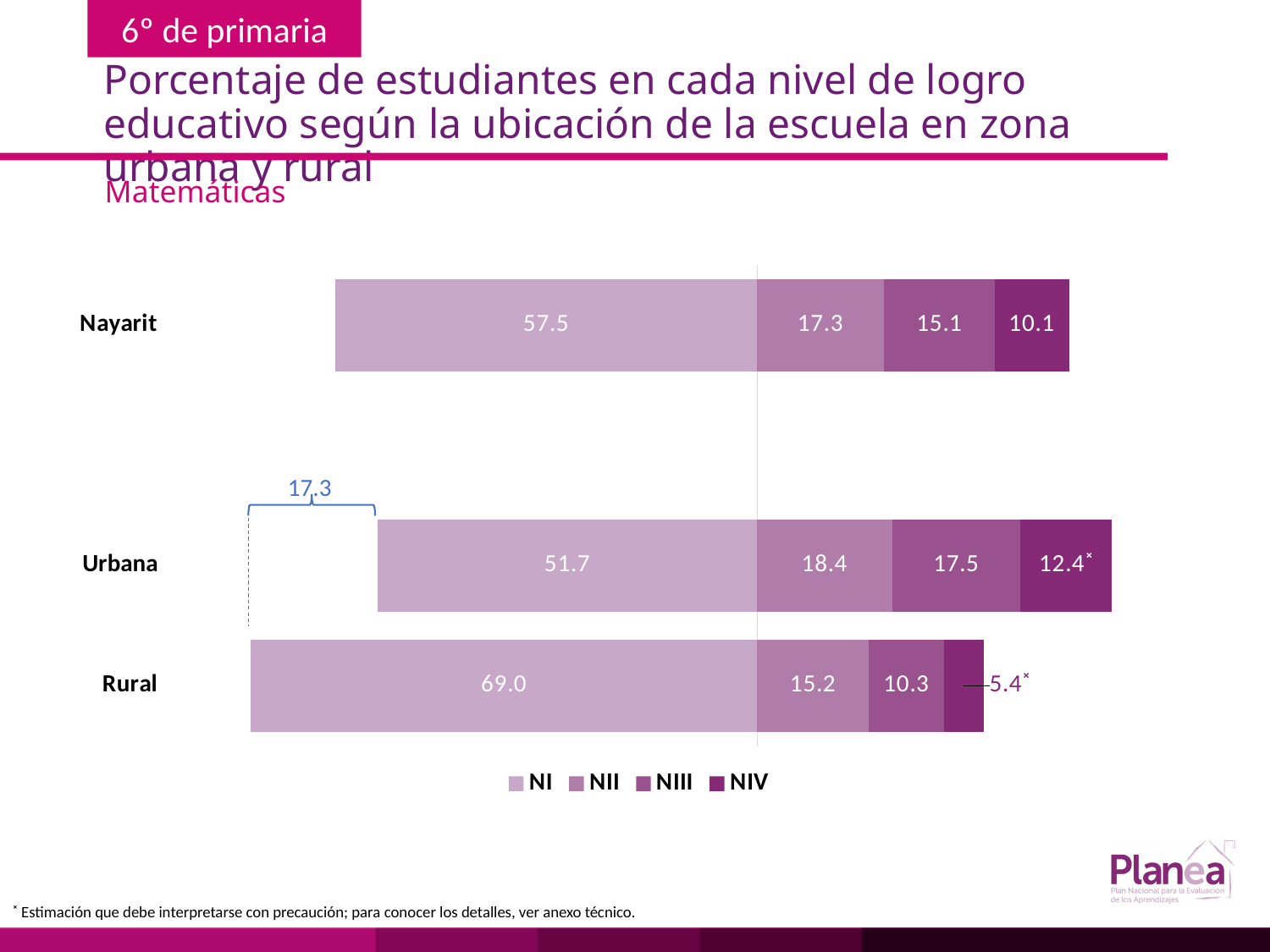
Which is larger, the NIII value for Urbana or the NIII value for Nayarit? Urbana What is the NIII value for Rural? 10.3 What is the NIV value for Nayarit? 10.1 How many categories (bars) are plotted in the chart? 3 What is the NII value for Urbana? 18.4 How many series does the legend list? 4 Which category has the highest NI value? Rural What is the difference between the NI values for Rural and Urbana? 17.3 What type of chart is shown on the slide? Stacked bar chart What is the NI value for Rural? 69.0 Which series is shown in the darkest shade in the legend? NIV Which category has the lowest NIV value? Rural